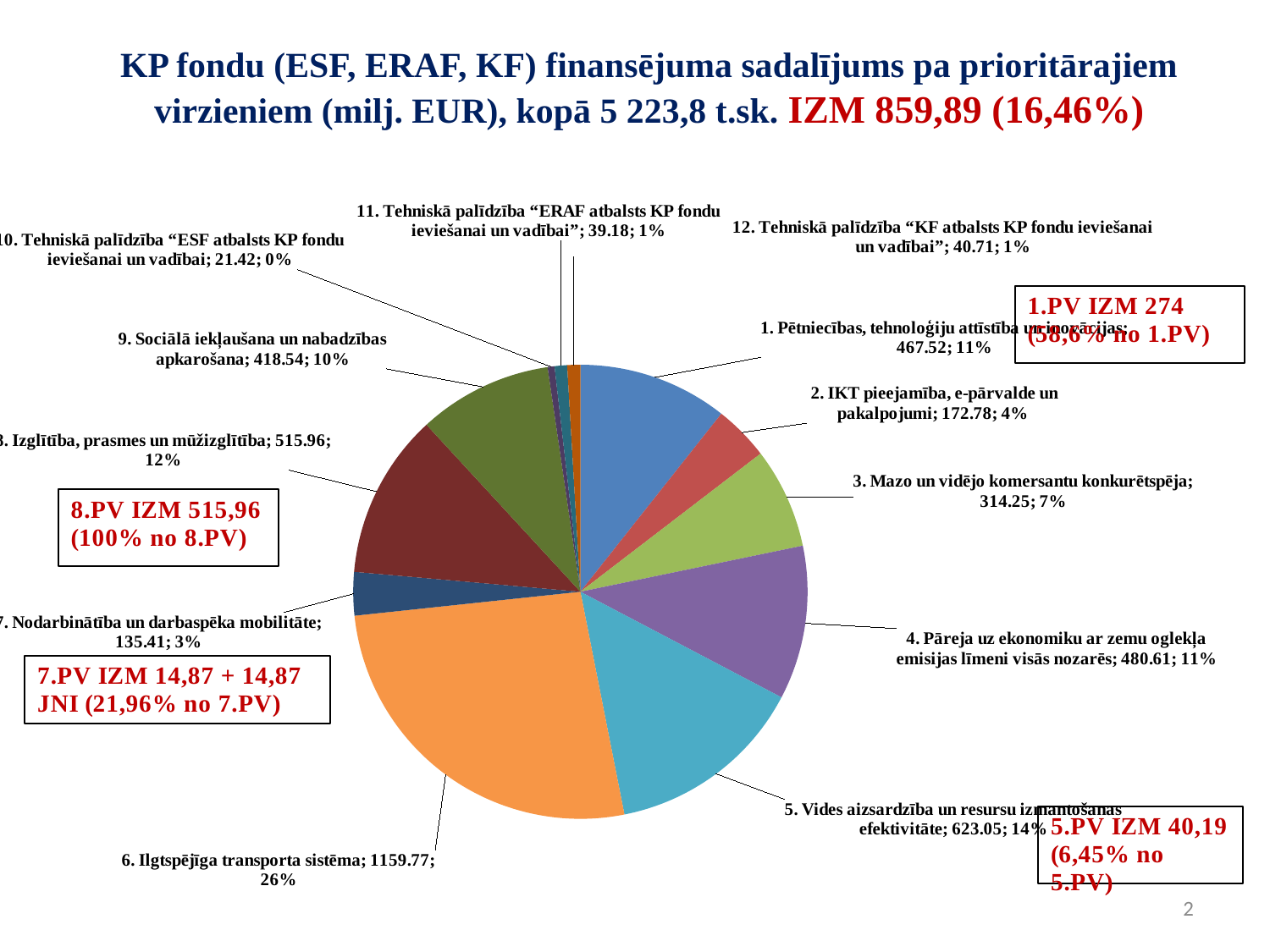
Which category has the smallest slice of the pie chart? 10. Tehniskā palīdzība "ESF atbalsts KP fondu ieviešanai un vadībai" What is the value shown for 3. Mazo un vidējo komersantu konkurētspēja? 314.25 Which category has the largest slice of the pie chart? 6. Ilgtspējīga transporta sistēma What is the value shown for 5. Vides aizsardzība un resursu izmantošanas efektivitāte? 623.05 What is the value shown for 6. Ilgtspējīga transporta sistēma? 1159.77 Which is larger: the value for 7. Nodarbinātība un darbaspēka mobilitāte or the value for 9. Sociālā iekļaušana un nabadzības apkarošana? 9. Sociālā iekļaušana un nabadzības apkarošana What share of the pie does 9. Sociālā iekļaušana un nabadzības apkarošana represent? 10% What share of the pie does 8. Izglītība, prasmes un mūžizglītība represent? 12% According to the slide title, what is the total KP fondu financing in million EUR? 5 223,8 What kind of chart is shown on the slide? pie chart How many slices does the pie chart have? 12 What is the difference between the values for 4. Pāreja uz ekonomiku ar zemu oglekļa emisijas līmeni visās nozarēs and 2. IKT pieejamība, e-pārvalde un pakalpojumi? 307.83